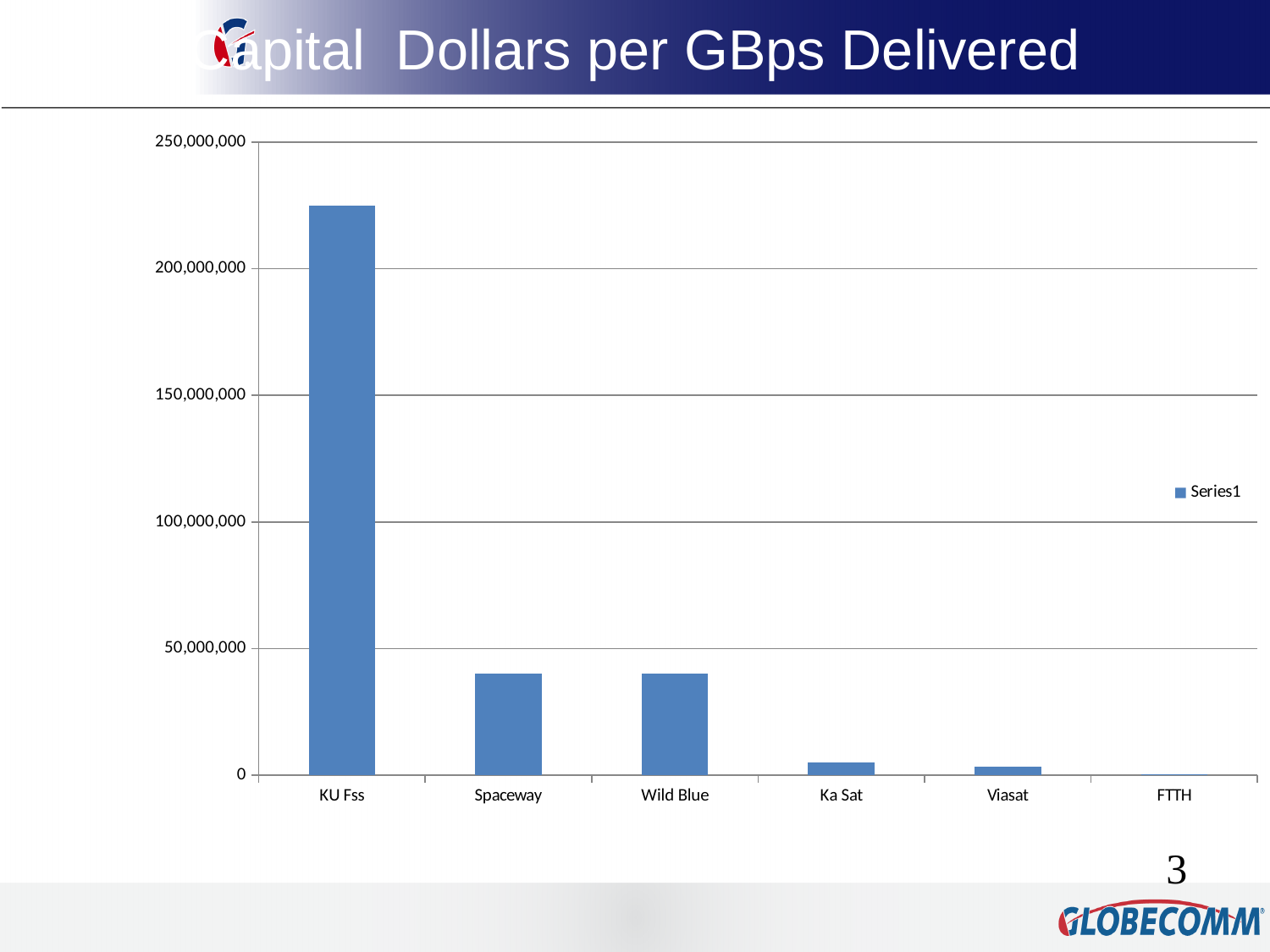
Is the value for Spaceway greater or less than 50,000,000? less Is the value for Wild Blue greater or less than 50,000,000? less How many categories are shown on the x axis? 6 Is the value for KU Fss greater or less than 200,000,000? greater Which category has the highest value? KU Fss Do the values generally rise or fall from left to right along the x axis? fall How many series does the legend list? 1 What kind of chart is shown on the slide? bar chart Which category has the lowest value? FTTH What is the name of the series shown in the legend? Series1 Which is larger, the value for KU Fss or the value for Spaceway? KU Fss